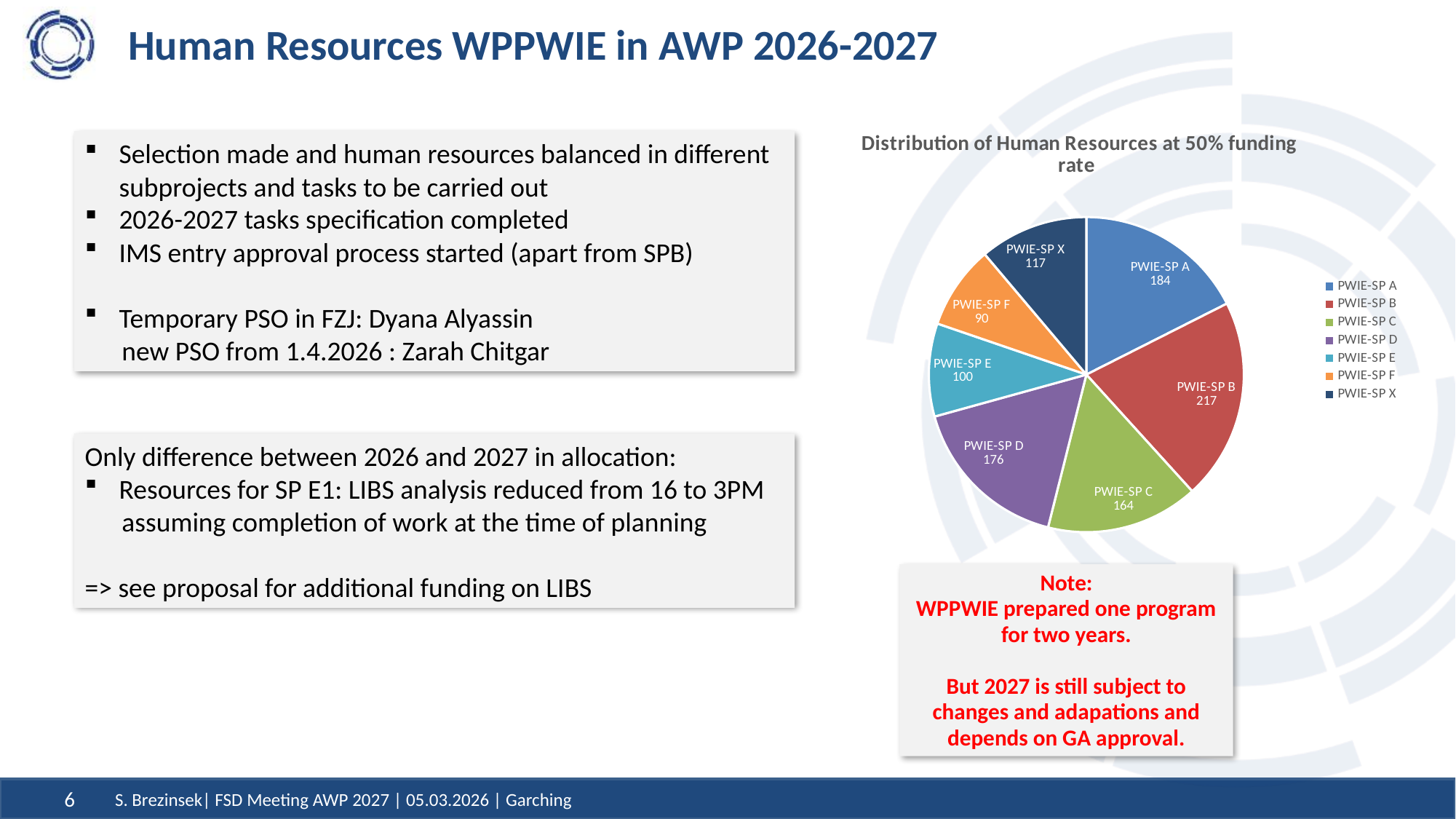
What is the difference between the values for PWIE-SP D and PWIE-SP E? 76 What is the value for PWIE-SP X in the pie chart? 117 What is the title of the chart? Distribution of Human Resources at 50% funding rate What is the total of all the values shown in the pie chart? 1048 What kind of chart is shown on the slide? Pie chart What is the value for PWIE-SP E in the pie chart? 100 How many slices does the pie chart have? 7 Which is larger, the value for PWIE-SP D or PWIE-SP C? PWIE-SP D What is the difference between the values for PWIE-SP B and PWIE-SP A? 33 What is the value for PWIE-SP B in the pie chart? 217 Which subproject has the smallest slice in the pie chart? PWIE-SP F Which subproject has the largest slice in the pie chart? PWIE-SP B